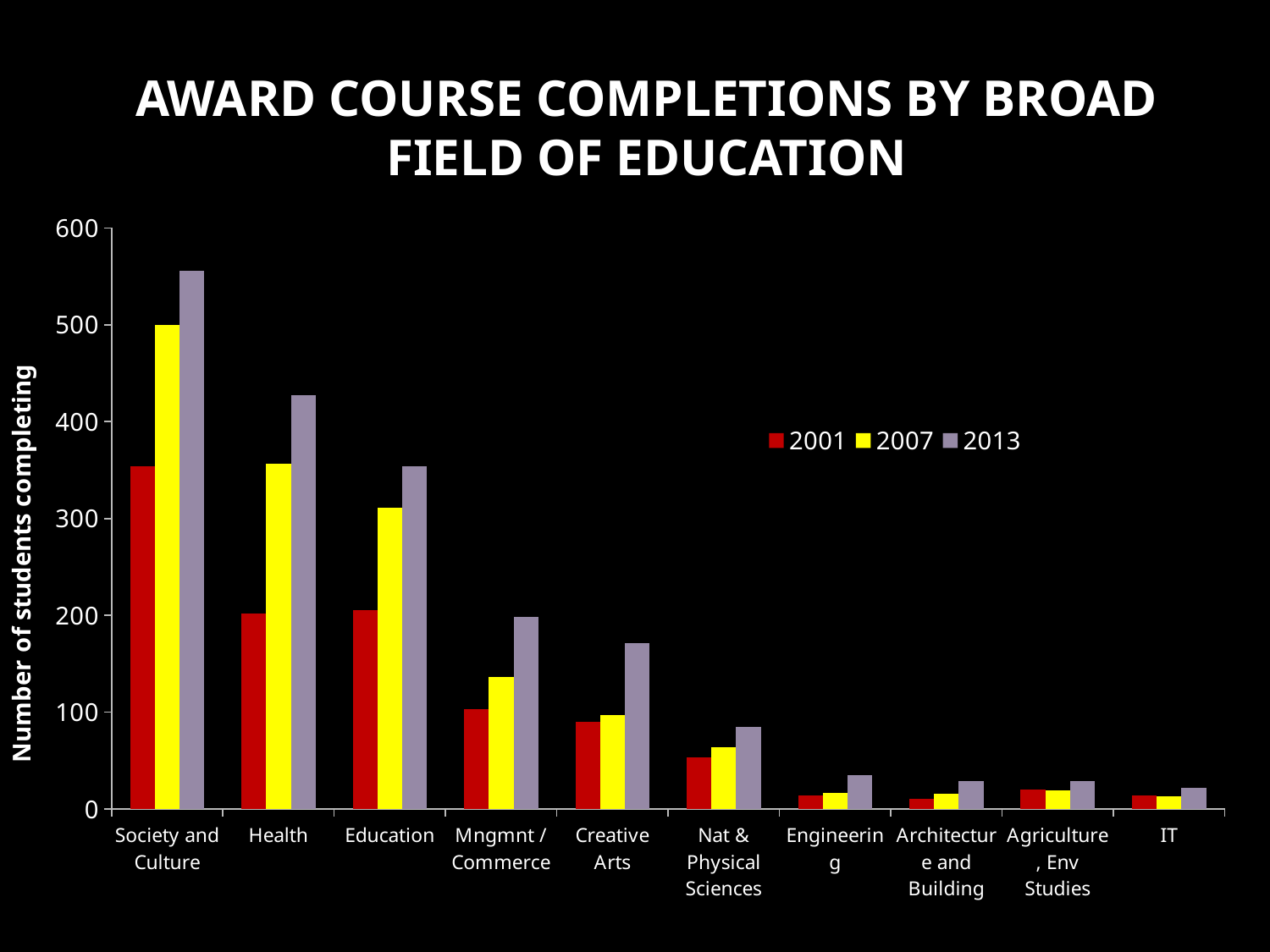
Is the 2013 value for Nat & Physical Sciences greater or less than 100? less Do the values for Society and Culture rise or fall from 2001 to 2013? rise Which field of education has the highest number of students completing in 2001? Society and Culture Which is larger, the 2013 value for Health or the 2013 value for Education? Health How many fields of education are shown on the x axis? 10 What kind of chart is shown on the slide? bar chart What is the label on the vertical axis? Number of students completing Is the 2013 value for Creative Arts greater or less than 200? less Is the 2013 value for Health greater or less than 400? greater How many series does the legend list? 3 Which field of education has the highest number of students completing in 2013? Society and Culture